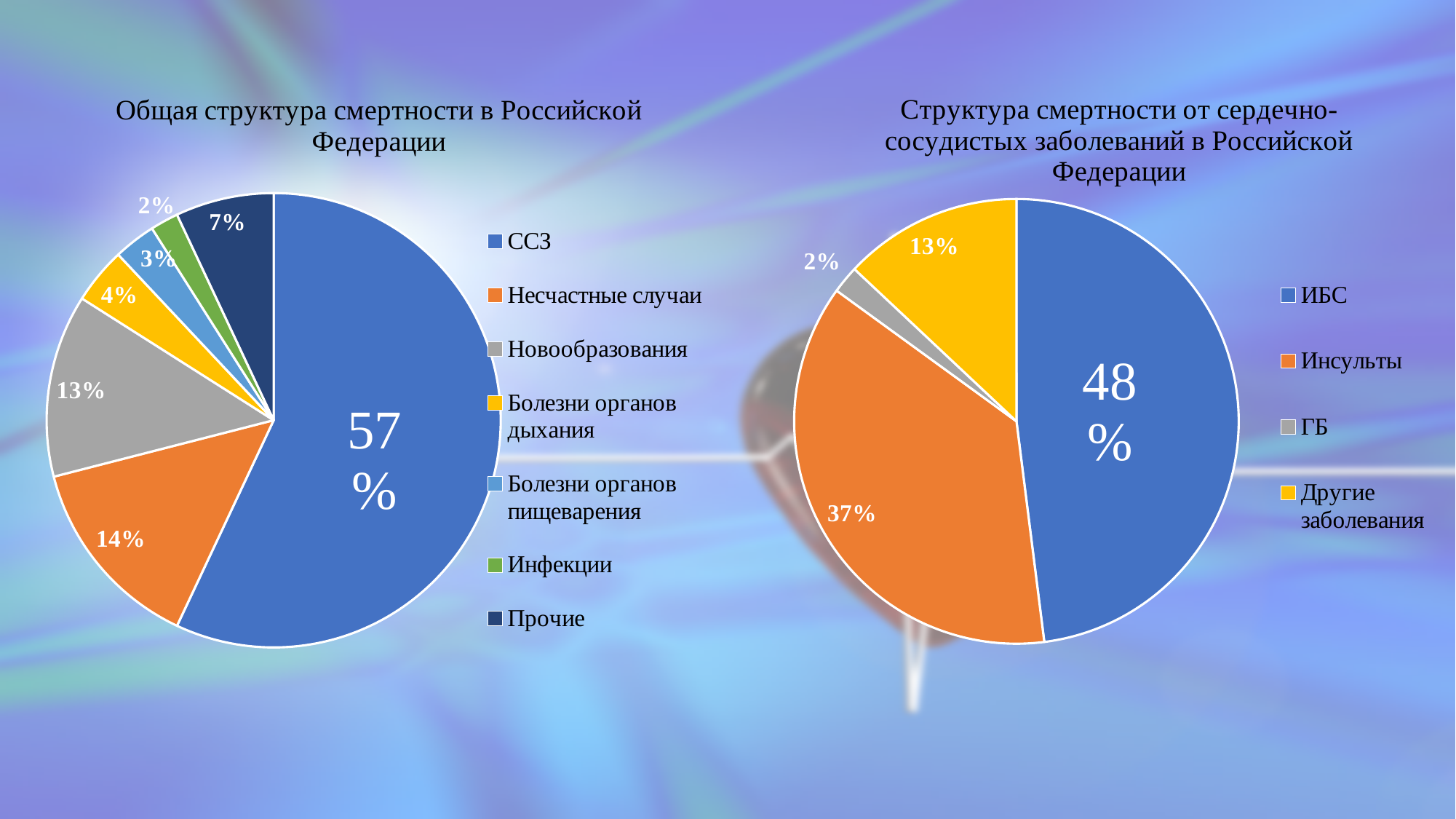
In the chart titled "Общая структура смертности в Российской Федерации", what is the difference between Несчастные случаи and Болезни органов дыхания? 10% In the chart titled "Структура смертности от сердечно-сосудистых заболеваний в Российской Федерации", what is the value for Инсульты? 37% In the chart titled "Структура смертности от сердечно-сосудистых заболеваний в Российской Федерации", which is larger, Инсульты or Другие заболевания? Инсульты In the chart titled "Структура смертности от сердечно-сосудистых заболеваний в Российской Федерации", what is the difference between ИБС and Инсульты? 11% In the chart titled "Общая структура смертности в Российской Федерации", what is the value for Прочие? 7% In the chart titled "Общая структура смертности в Российской Федерации", how many categories does the legend list? 7 In the chart titled "Структура смертности от сердечно-сосудистых заболеваний в Российской Федерации", what share does ИБС have? 48% In the chart titled "Общая структура смертности в Российской Федерации", which category has the smallest share? Инфекции What type of chart is the one on the right side of the slide? Pie chart In the chart titled "Общая структура смертности в Российской Федерации", what is the value for Несчастные случаи? 14% In the chart titled "Общая структура смертности в Российской Федерации", what share does ССЗ have? 57% In the chart titled "Общая структура смертности в Российской Федерации", what is the value for Новообразования? 13%